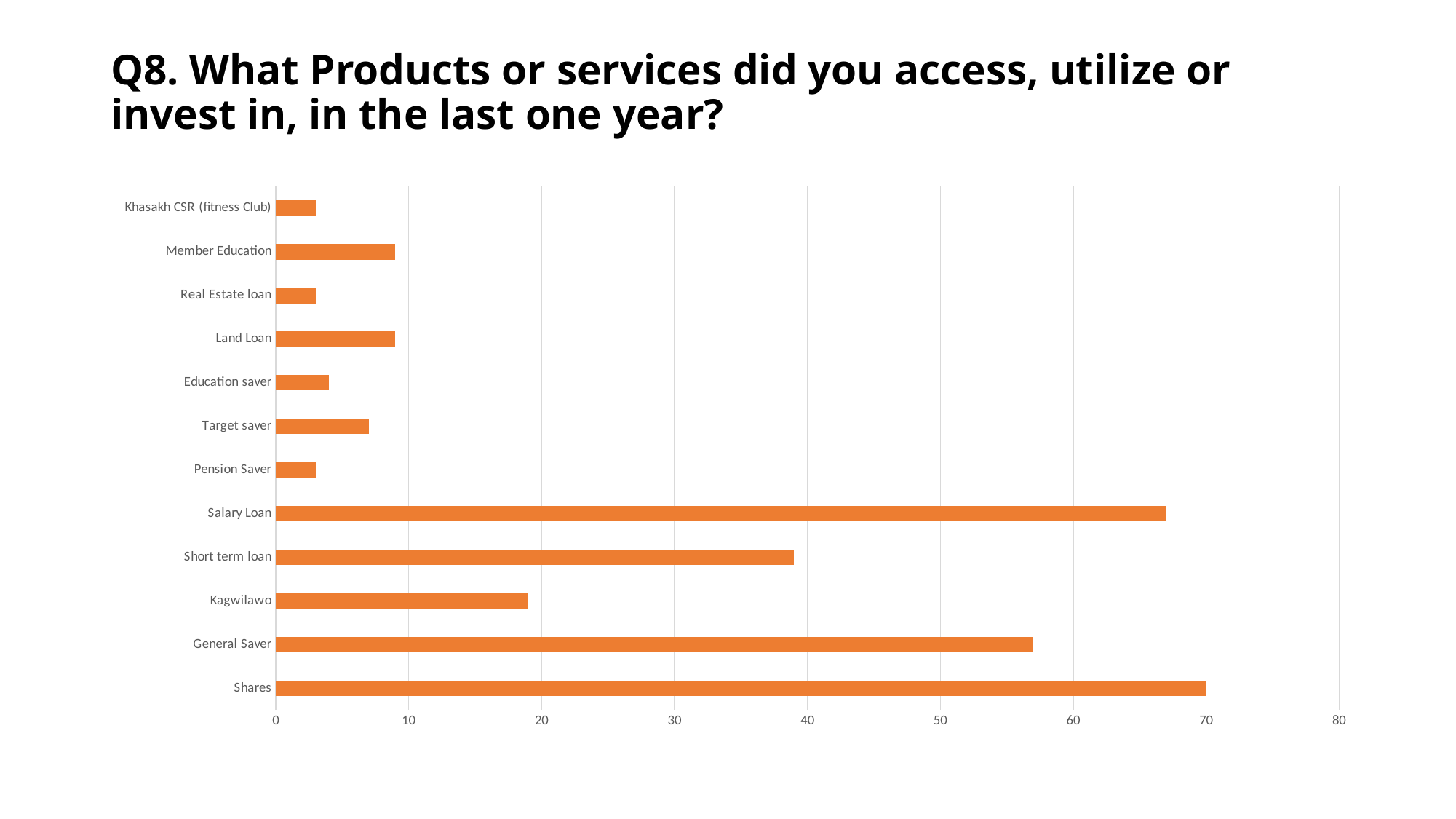
What is the title of the slide containing the chart? Q8. What Products or services did you access, utilize or invest in, in the last one year? Which is larger, the value for Salary Loan or the value for General Saver? Salary Loan What kind of chart is shown on the slide? bar chart Which product or service has the highest value in the chart? Shares Which is larger, the value for Member Education or the value for Target saver? Member Education What is the value for Shares? 70 Is the value for Salary Loan greater or less than 60? greater Is the value for General Saver greater or less than 50? greater How many categories (products or services) are plotted in the chart? 12